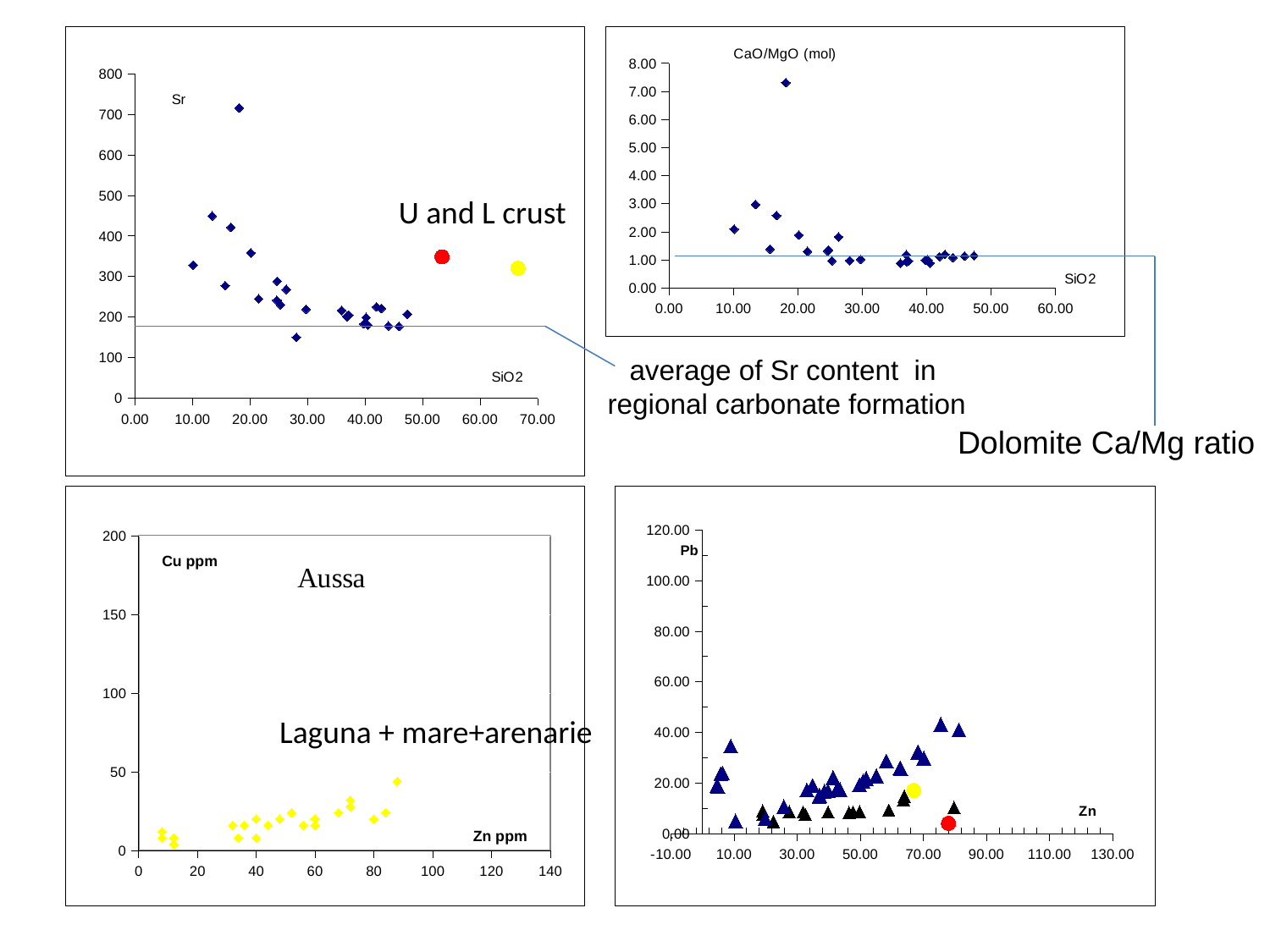
In the top-right CaO/MgO (mol) chart, do the values generally rise or fall as SiO2 increases? fall How many charts are shown on the slide? 4 In the bottom-left Cu ppm chart, is the highest plotted Cu value greater or less than 50? less In the top-right CaO/MgO (mol) chart, is the highest plotted value greater or less than 6.00? greater In the bottom-right Pb chart, is the highest plotted Pb value greater or less than 60.00? less What kind of chart is the top-left chart labelled Sr? scatter chart In the top-left Sr chart, do the Sr values generally rise or fall as SiO2 increases? fall In the bottom-left Cu ppm chart, do the Cu values generally rise or fall as Zn ppm increases? rise What is the y-axis label of the top-right chart? CaO/MgO (mol) In the top-left Sr chart, what is the maximum value shown on the vertical axis? 800